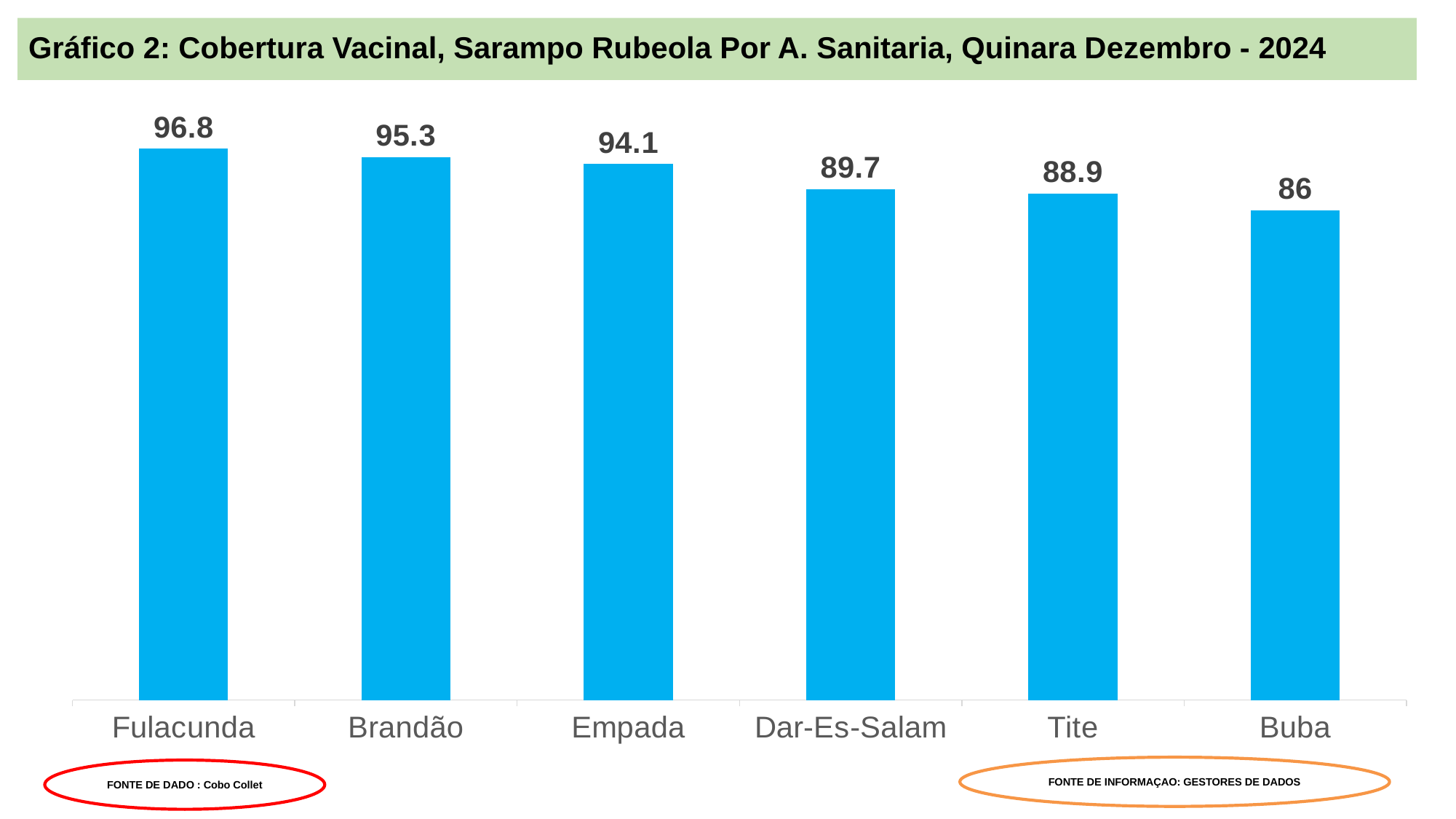
What is the difference between the values for Fulacunda and Buba? 10.8 What is the value for Tite? 88.9 What is the value for Fulacunda? 96.8 Which is larger, the value for Empada or the value for Tite? Empada What is the value for Buba? 86 Which category has the lowest value? Buba Do the values rise or fall from left to right along the x axis? Fall How many categories are shown on the chart? 6 What is the difference between the values for Brandão and Empada? 1.2 Which category has the highest value? Fulacunda What kind of chart is shown on the slide? Bar chart What is the value for Dar-Es-Salam? 89.7